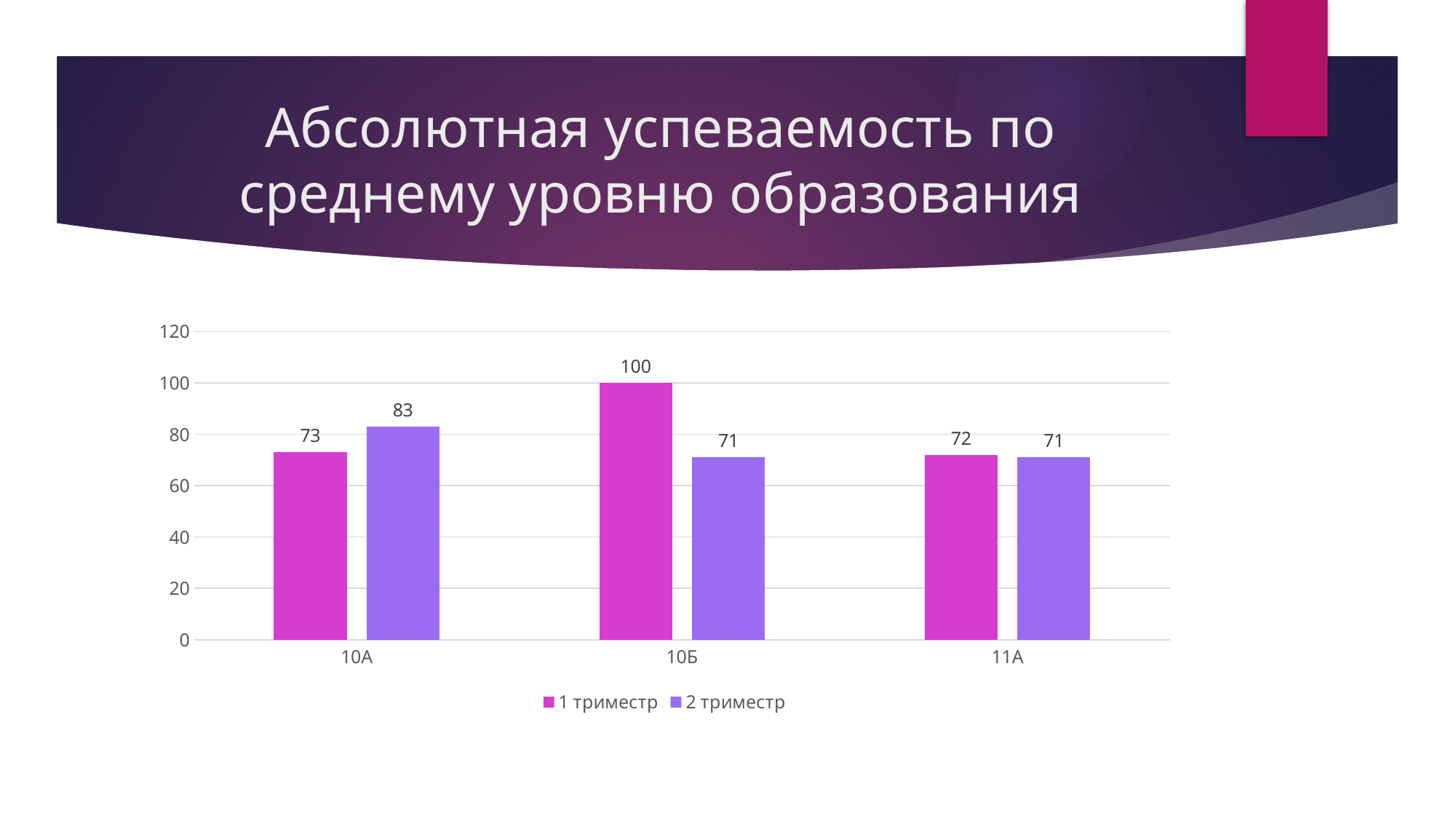
What is the value for 10А in the 1 триместр series? 73 How many categories are shown on the x axis? 3 Which category has the highest value in the 1 триместр series? 10Б What is the value for 11А in the 1 триместр series? 72 What is the value for 10Б in the 2 триместр series? 71 What kind of chart is shown on the slide? bar chart Which category has the lowest value in the 2 триместр series? 10Б and 11А (both 71) What is the difference between the 2 триместр and 1 триместр values for 10А? 10 What is the difference between the 1 триместр and 2 триместр values for 10Б? 29 Which is larger for 10А: the 1 триместр value or the 2 триместр value? 2 триместр How many series does the legend list? 2 Is the 1 триместр value for 10Б greater or less than 80? greater